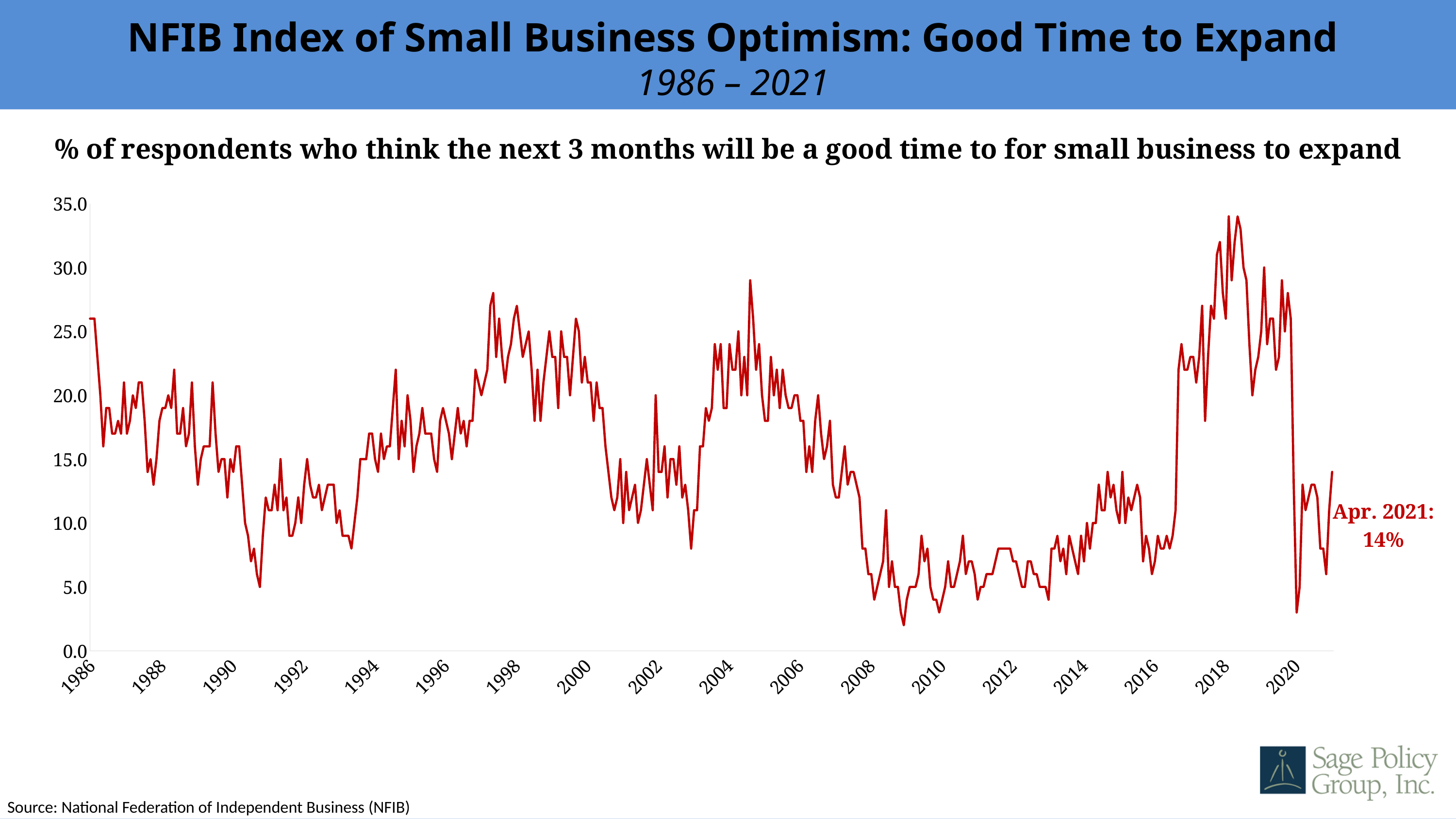
Does the line generally rise or fall between 2016 and 2018? rise Around which year does the line reach its lowest value? 2009 What value is labelled for Apr. 2021 on the chart? 14% What is the highest value shown on the y-axis? 35.0 Does the line generally rise or fall between 2005 and 2009? fall Is the sharp low point in 2020 greater or less than 5? less Around which year does the line reach its highest value? 2018 Is the low point reached around 1991 greater or less than 10? less Is the lowest value reached around 2009 greater or less than 5? less What kind of chart is shown on the slide? line chart What source is cited for the chart data? National Federation of Independent Business (NFIB)